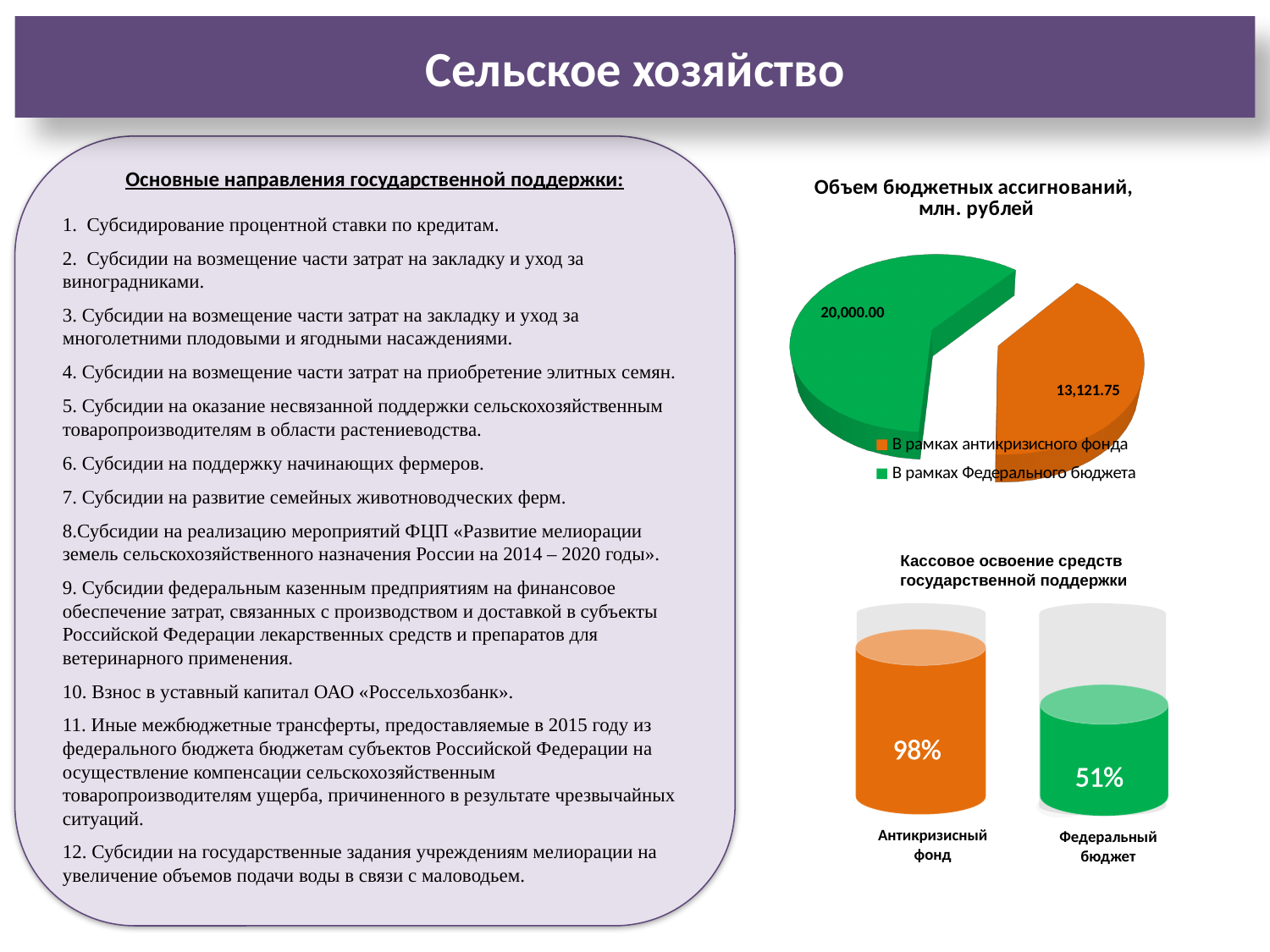
In the chart 'Кассовое освоение средств государственной поддержки', what is the difference between the values for 'Антикризисный фонд' and 'Федеральный бюджет'? 47% In the pie chart 'Объем бюджетных ассигнований, млн. рублей', what is the value for 'В рамках антикризисного фонда'? 13,121.75 In the pie chart 'Объем бюджетных ассигнований, млн. рублей', what is the difference between the value for 'В рамках Федерального бюджета' and the value for 'В рамках антикризисного фонда'? 6,878.25 In the pie chart 'Объем бюджетных ассигнований, млн. рублей', how many slices are there? 2 In the pie chart 'Объем бюджетных ассигнований, млн. рублей', what colour is the slice for 'В рамках антикризисного фонда'? Orange What type of chart is 'Объем бюджетных ассигнований, млн. рублей'? Pie chart In the chart 'Кассовое освоение средств государственной поддержки', what is the value for 'Федеральный бюджет'? 51% In the pie chart 'Объем бюджетных ассигнований, млн. рублей', which category has the largest slice? В рамках Федерального бюджета In the chart 'Кассовое освоение средств государственной поддержки', which category has the higher value, 'Антикризисный фонд' or 'Федеральный бюджет'? Антикризисный фонд In the pie chart 'Объем бюджетных ассигнований, млн. рублей', which category has the smallest slice? В рамках антикризисного фонда In the chart 'Кассовое освоение средств государственной поддержки', what is the value for 'Антикризисный фонд'? 98% In the pie chart 'Объем бюджетных ассигнований, млн. рублей', what is the value for 'В рамках Федерального бюджета'? 20,000.00